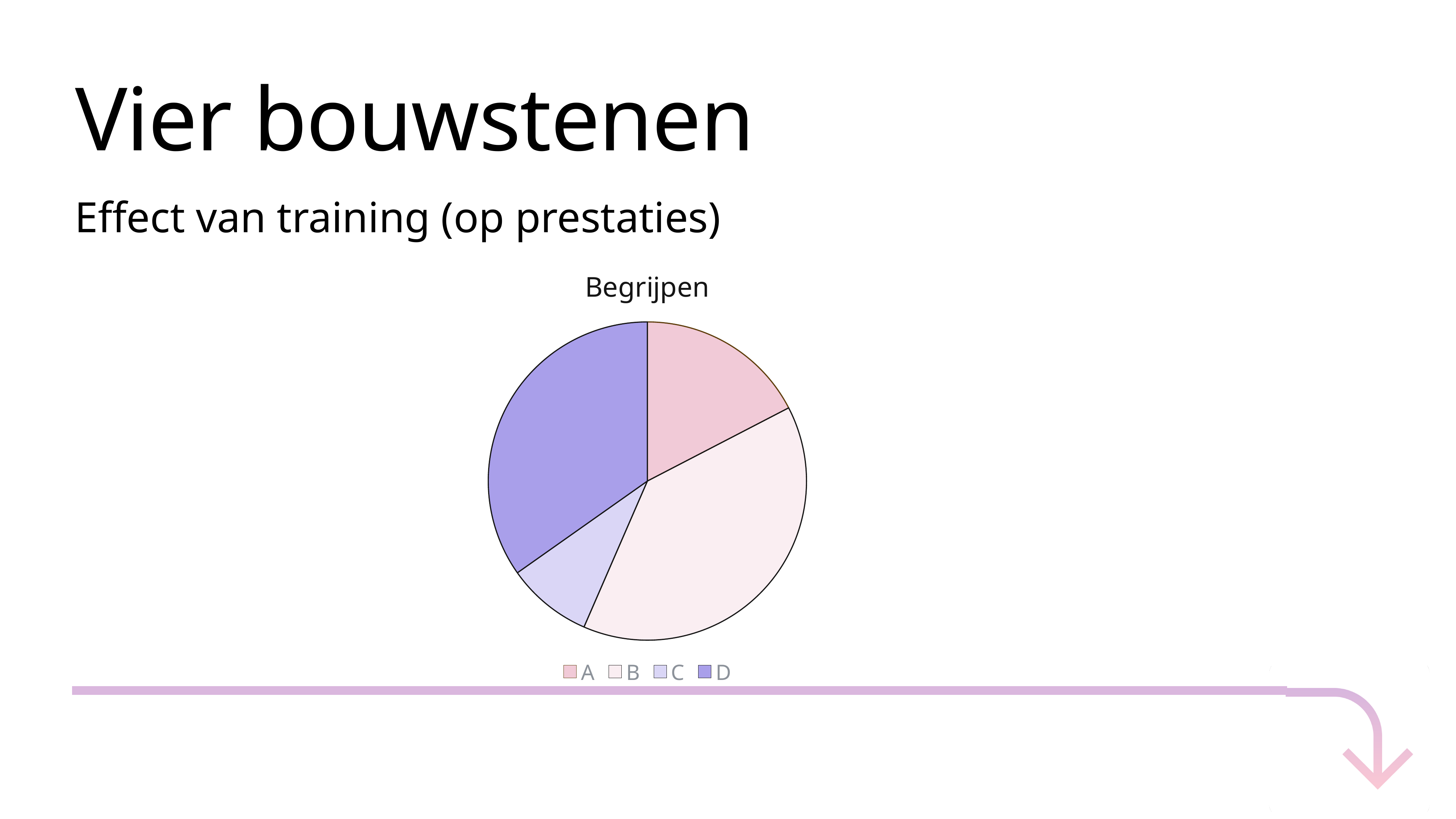
Which category has the largest slice of the pie? B Which slice is larger, A or C? A How many slices does the pie chart have? 4 Which slice is larger, A or D? D Which category has the smallest slice of the pie? C What kind of chart is shown on the slide? pie chart Which slice is larger, C or D? D What are the legend entries of the chart, in order? A, B, C, D How many entries does the legend list? 4 What is the title of the chart? Begrijpen